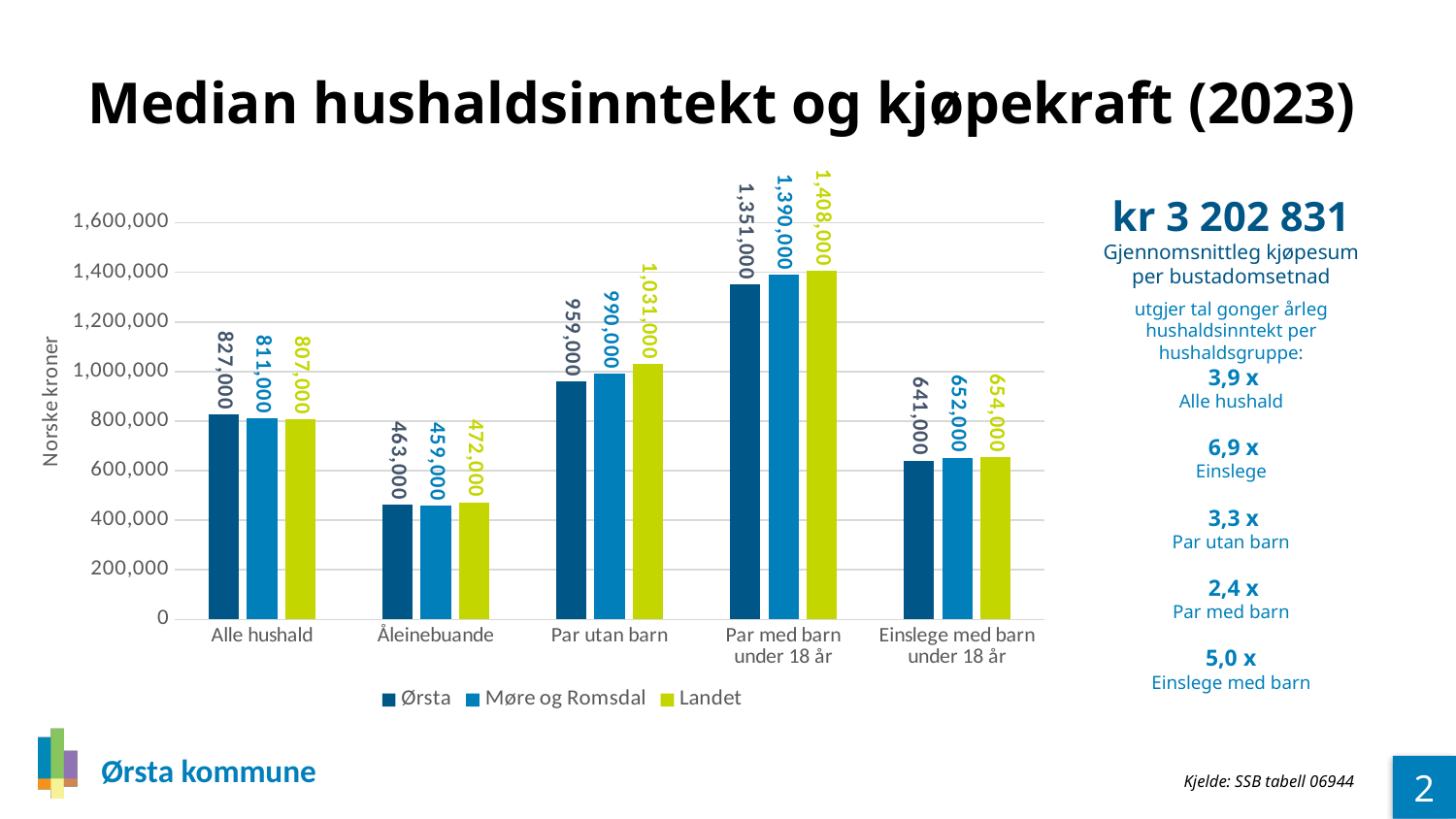
What is the label on the vertical axis of the chart? Norske kroner What is the difference between the Landet and Ørsta values in the Par utan barn category? 72,000 Which category has the lowest value for Ørsta? Åleinebuande Is the value for Møre og Romsdal in the Einslege med barn under 18 år category greater or less than 800,000? less Which category has the highest value for Landet? Par med barn under 18 år What is the value for Ørsta in the Par utan barn category? 959,000 What kind of chart is shown on the slide? bar chart How many series does the legend list? 3 What is the value for Landet in the Åleinebuande category? 472,000 Which is larger in the Alle hushald category, the value for Ørsta or the value for Landet? Ørsta How many categories are shown on the x axis? 5 What is the value for Møre og Romsdal in the Par med barn under 18 år category? 1,390,000